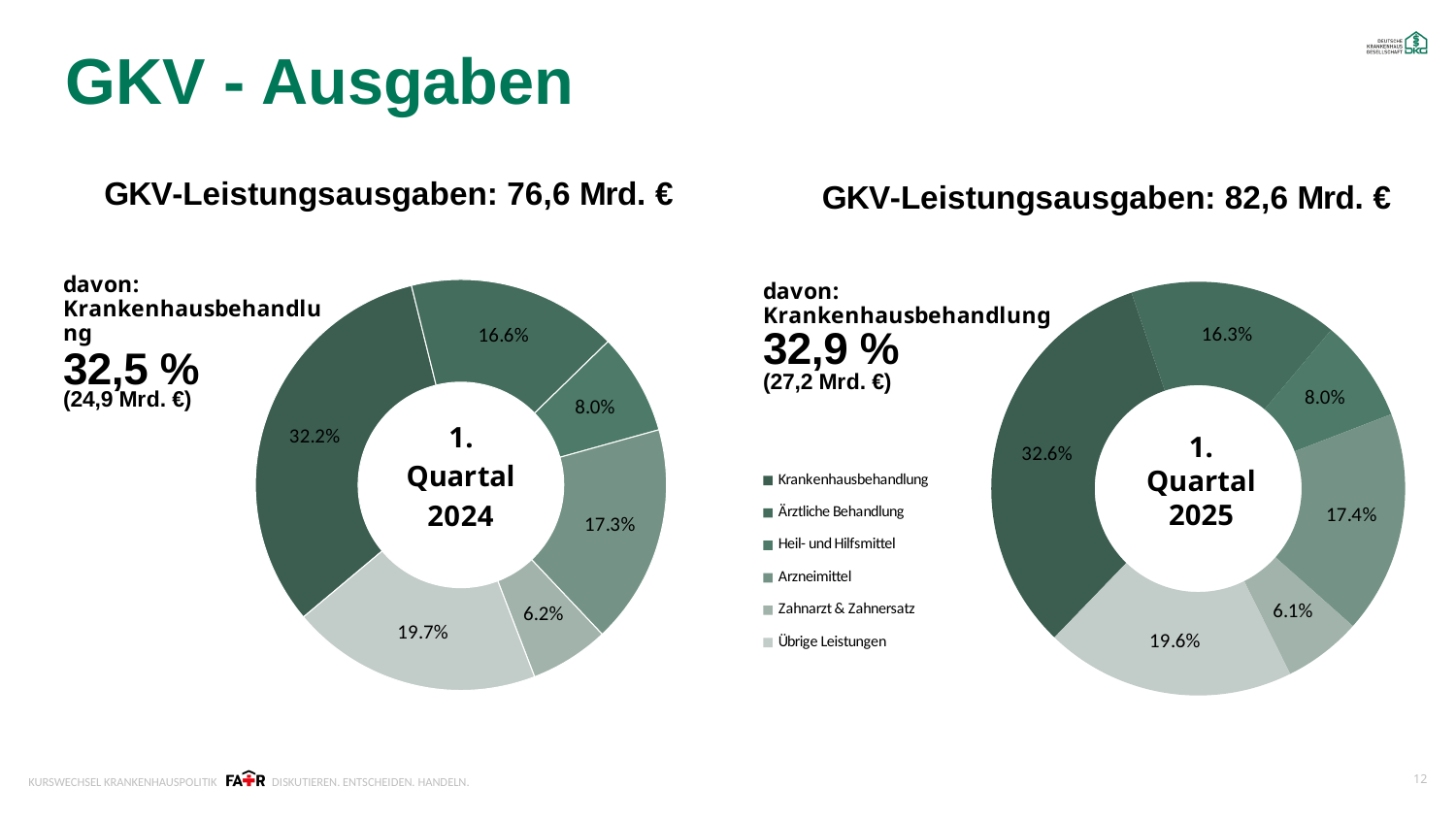
In the 1. Quartal 2024 chart, which is larger: the Arzneimittel slice or the Ärztliche Behandlung slice? Arzneimittel In the 1. Quartal 2025 chart, what is the smallest slice's share? 6.1% In the 1. Quartal 2025 chart, what share is shown for Arzneimittel? 17.4% In the 1. Quartal 2024 chart, what share is shown for Übrige Leistungen? 19.7% What is the difference between the Krankenhausbehandlung share in the 1. Quartal 2025 chart and in the 1. Quartal 2024 chart? 0.4% In the 1. Quartal 2024 chart, what share is labelled on the largest slice? 32.2% In the 1. Quartal 2024 chart, what is the smallest slice's share? 6.2% In the 1. Quartal 2025 chart, what share is labelled on the largest slice? 32.6% How many entries does the legend list? 6 What kind of chart is the 1. Quartal 2024 chart? Donut (pie) chart Which legend entry is listed first? Krankenhausbehandlung How many slices does the 1. Quartal 2025 chart have? 6